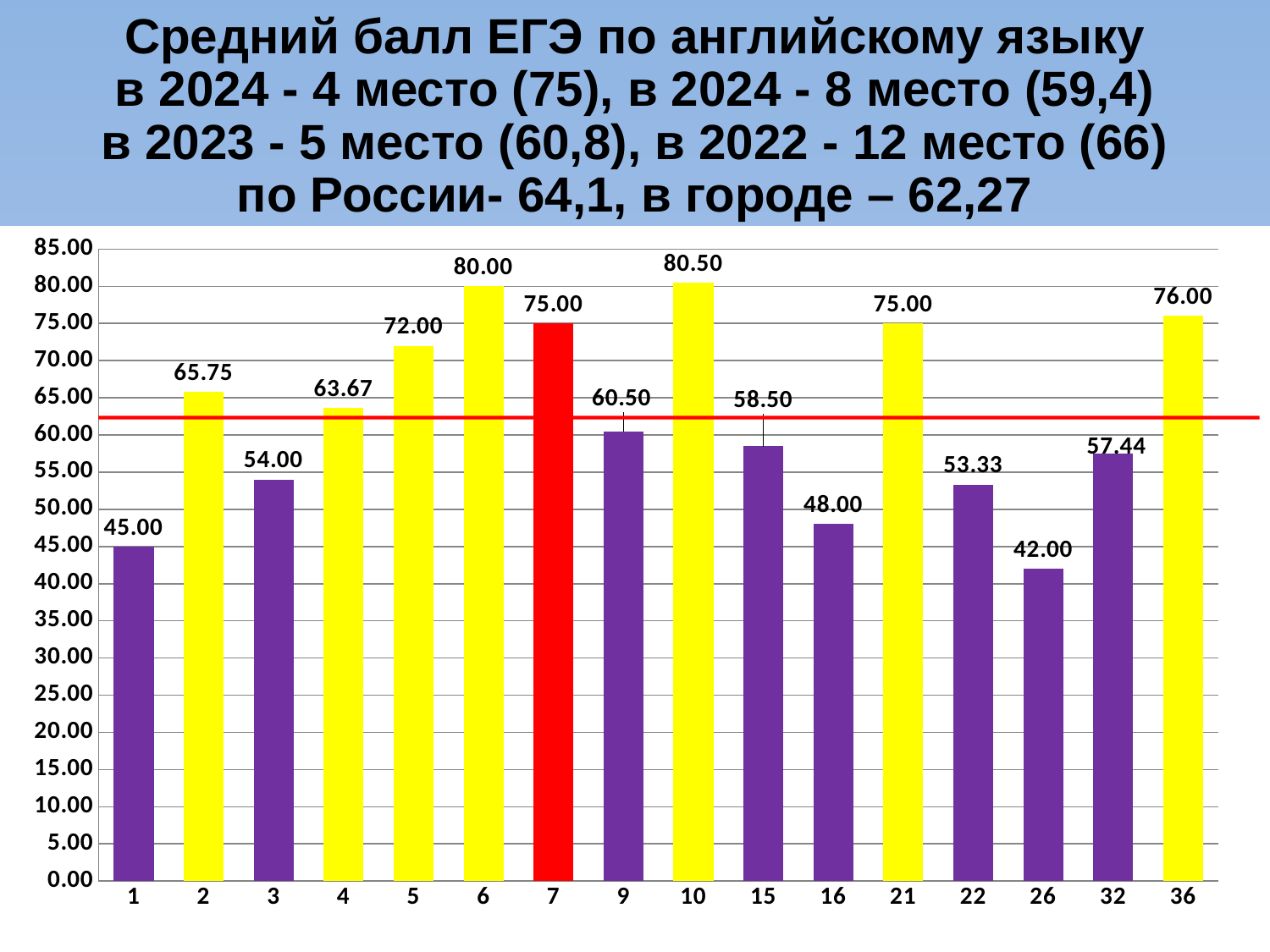
Which category has the lowest value? 26 What is the value for category 22? 53.33 What is the difference between the values for category 6 and category 1? 35.00 Which category has the highest value? 10 What is the difference between the values for category 10 and category 9? 20.00 Is the value for category 16 greater or less than 50.00? less What colour is the bar for category 7? red What is the value for category 36? 76.00 What kind of chart is shown on the slide? bar chart How many bars are shown in the chart? 16 What is the value for category 5? 72.00 Which has a larger value, category 2 or category 4? 2